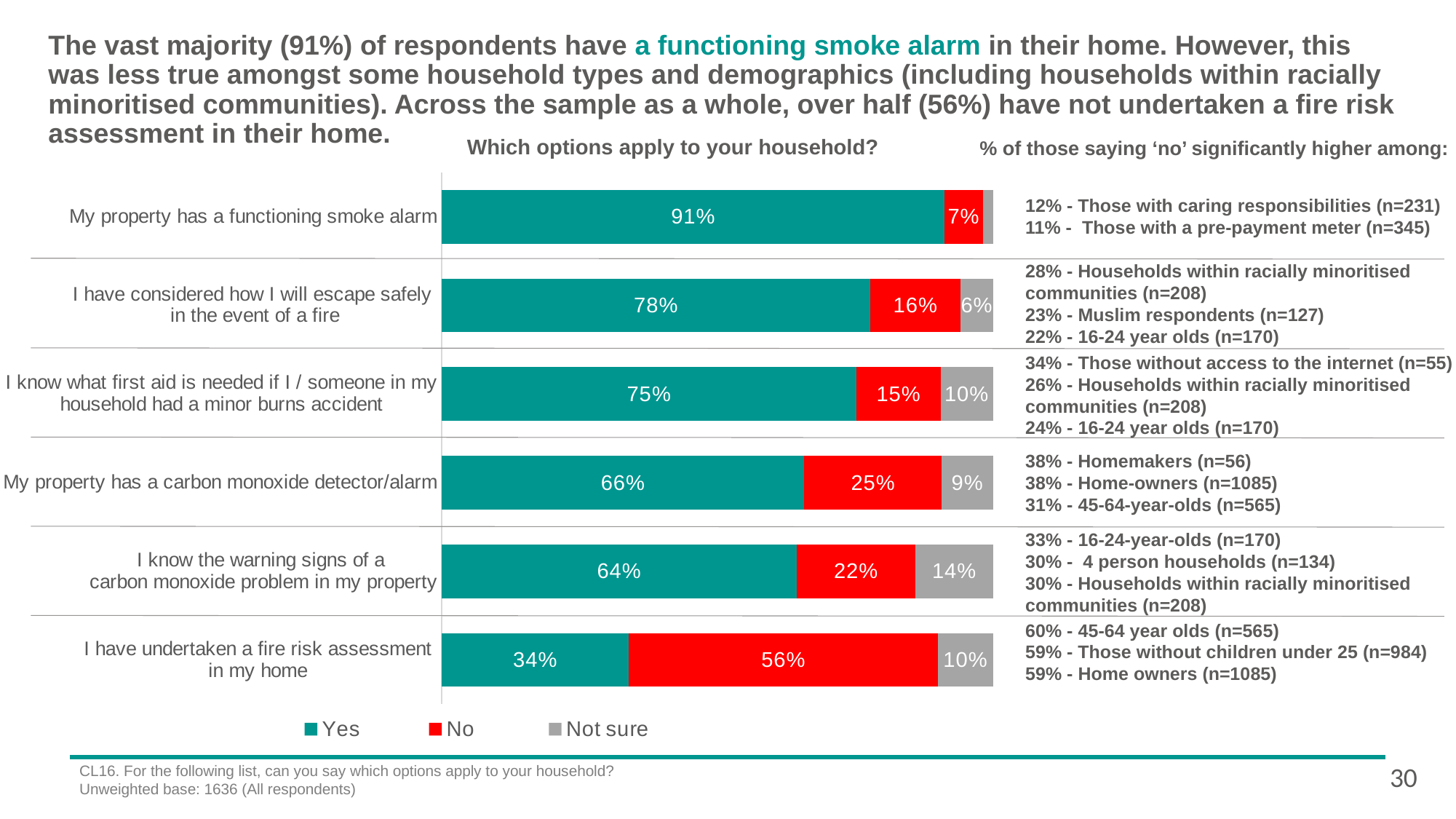
What percentage of respondents said 'Yes' to 'My property has a functioning smoke alarm'? 91% Which option has the highest 'Yes' percentage? My property has a functioning smoke alarm What percentage of respondents said 'No' to 'I have undertaken a fire risk assessment in my home'? 56% What type of chart is shown on the slide? Stacked bar chart Which option has the lowest 'Yes' percentage? I have undertaken a fire risk assessment in my home What is the title of the chart? Which options apply to your household? Which has a larger 'No' percentage: 'My property has a carbon monoxide detector/alarm' or 'I know the warning signs of a carbon monoxide problem in my property'? My property has a carbon monoxide detector/alarm For 'My property has a carbon monoxide detector/alarm', what is the difference between the 'Yes' and 'No' percentages? 41% How many options (categories) are shown in the chart? 6 What percentage of respondents said 'Not sure' to 'I know the warning signs of a carbon monoxide problem in my property'? 14% How many series does the legend list? 3 What percentage of respondents said 'No' to 'I have considered how I will escape safely in the event of a fire'? 16%